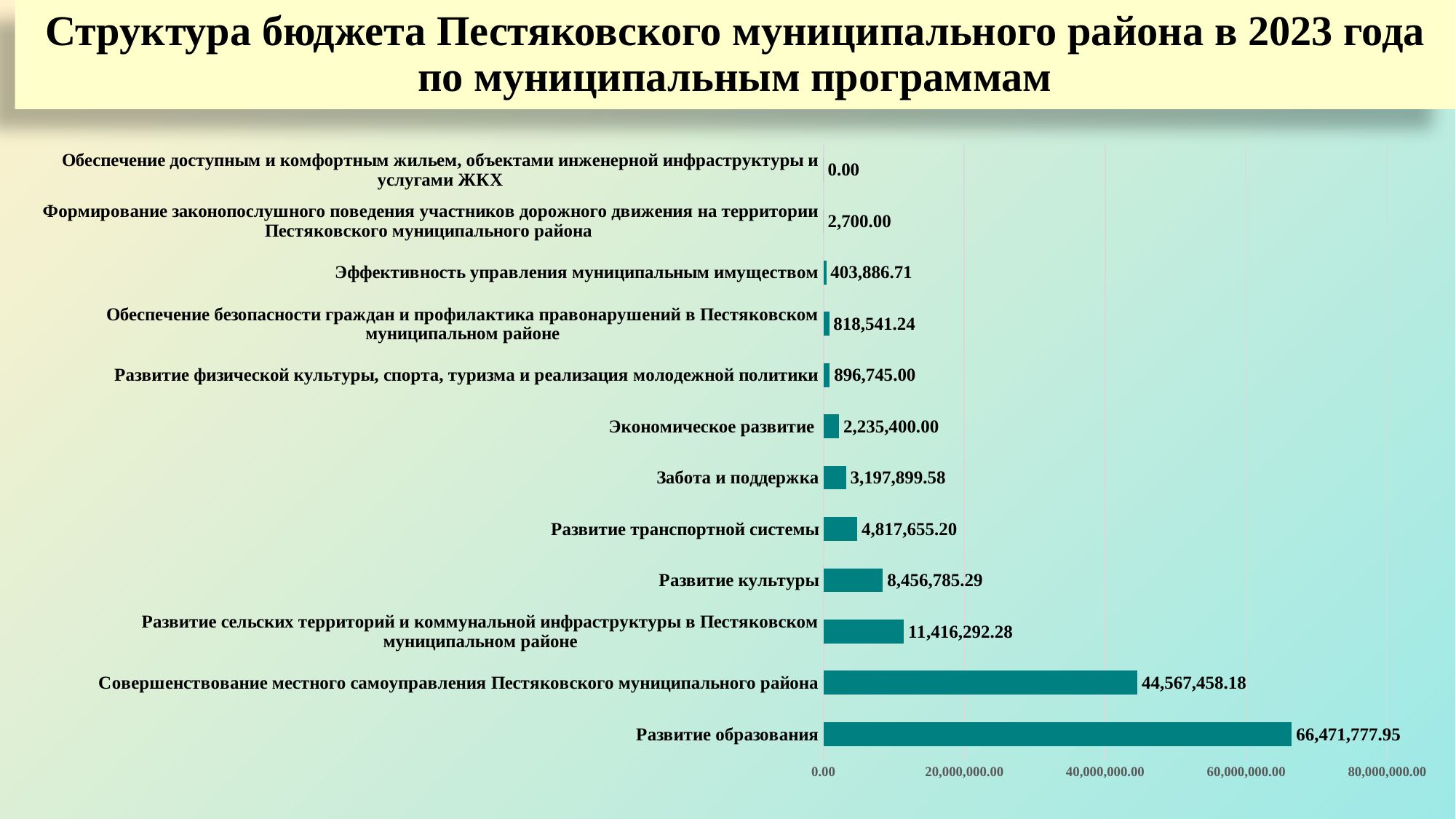
What is the value for Эффективность управления муниципальным имуществом? 403,886.71 Which is larger: the value for Экономическое развитие or the value for Развитие транспортной системы? Развитие транспортной системы What is the difference between the values for Развитие образования and Совершенствование местного самоуправления Пестяковского муниципального района? 21,904,319.77 How many categories (municipal programmes) are plotted in the chart? 12 What is the value for Развитие образования? 66,471,777.95 What kind of chart is shown on the slide? Bar chart What is the difference between the values for Развитие культуры and Развитие транспортной системы? 3,639,130.09 Which programme has the highest value in the chart? Развитие образования Is the value for Совершенствование местного самоуправления Пестяковского муниципального района greater or less than 40,000,000.00? greater Which programme has the lowest value in the chart? Обеспечение доступным и комфортным жильем, объектами инженерной инфраструктуры и услугами ЖКХ What is the value for Развитие культуры? 8,456,785.29 What is the value for Забота и поддержка? 3,197,899.58